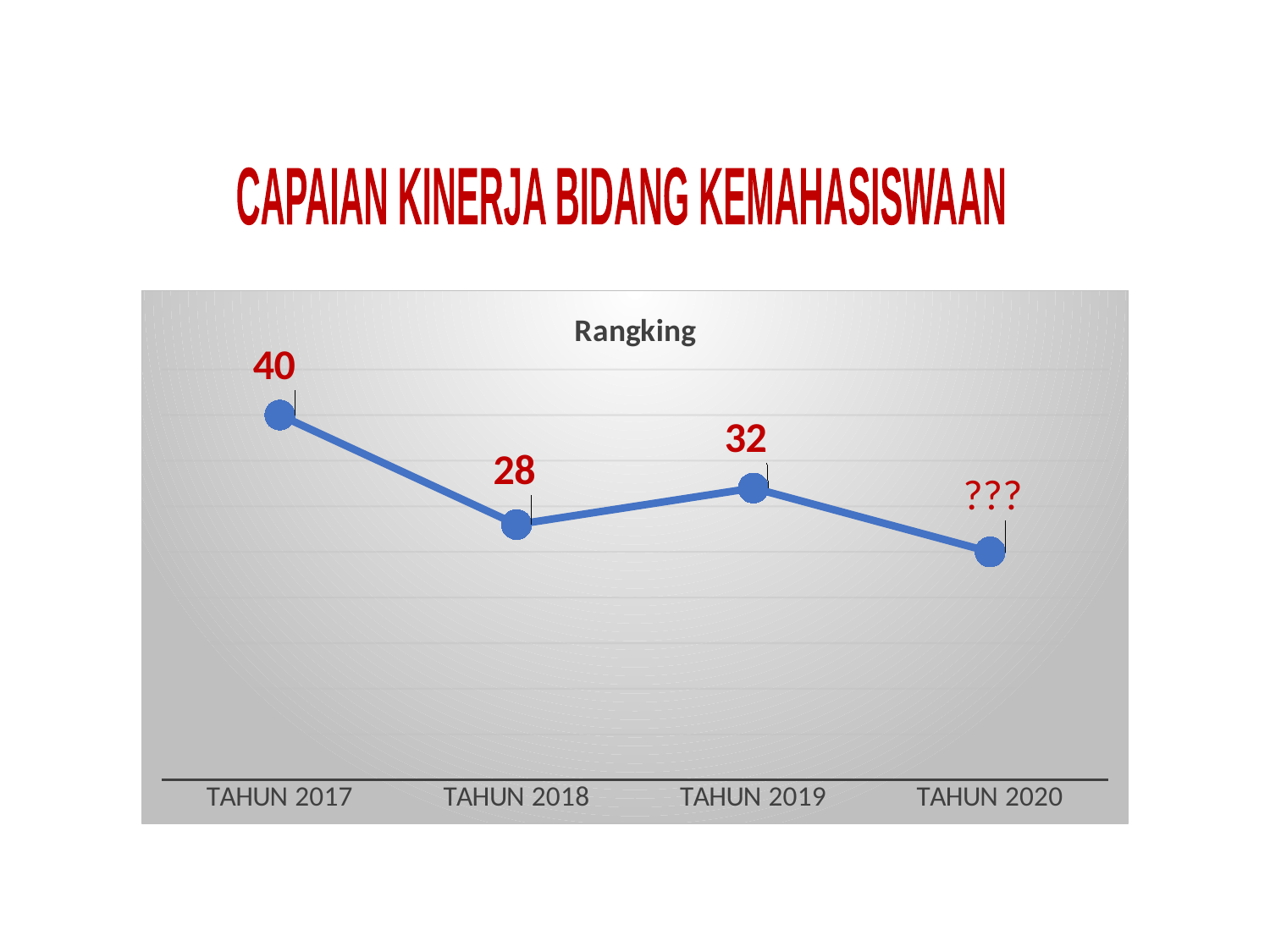
What is the value for TAHUN 2019? 32 What is the title of the chart? Rangking What is the difference between the values for TAHUN 2017 and TAHUN 2018? 12 Which year has the lowest labelled value? TAHUN 2018 What is the value for TAHUN 2018? 28 Which year has the highest labelled value? TAHUN 2017 What label is shown for the TAHUN 2020 data point? ??? What is the value for TAHUN 2017? 40 What is the difference between the values for TAHUN 2019 and TAHUN 2018? 4 What kind of chart is shown? line chart How many data points are plotted on the chart? 4 Which is larger, the value for TAHUN 2019 or TAHUN 2018? TAHUN 2019